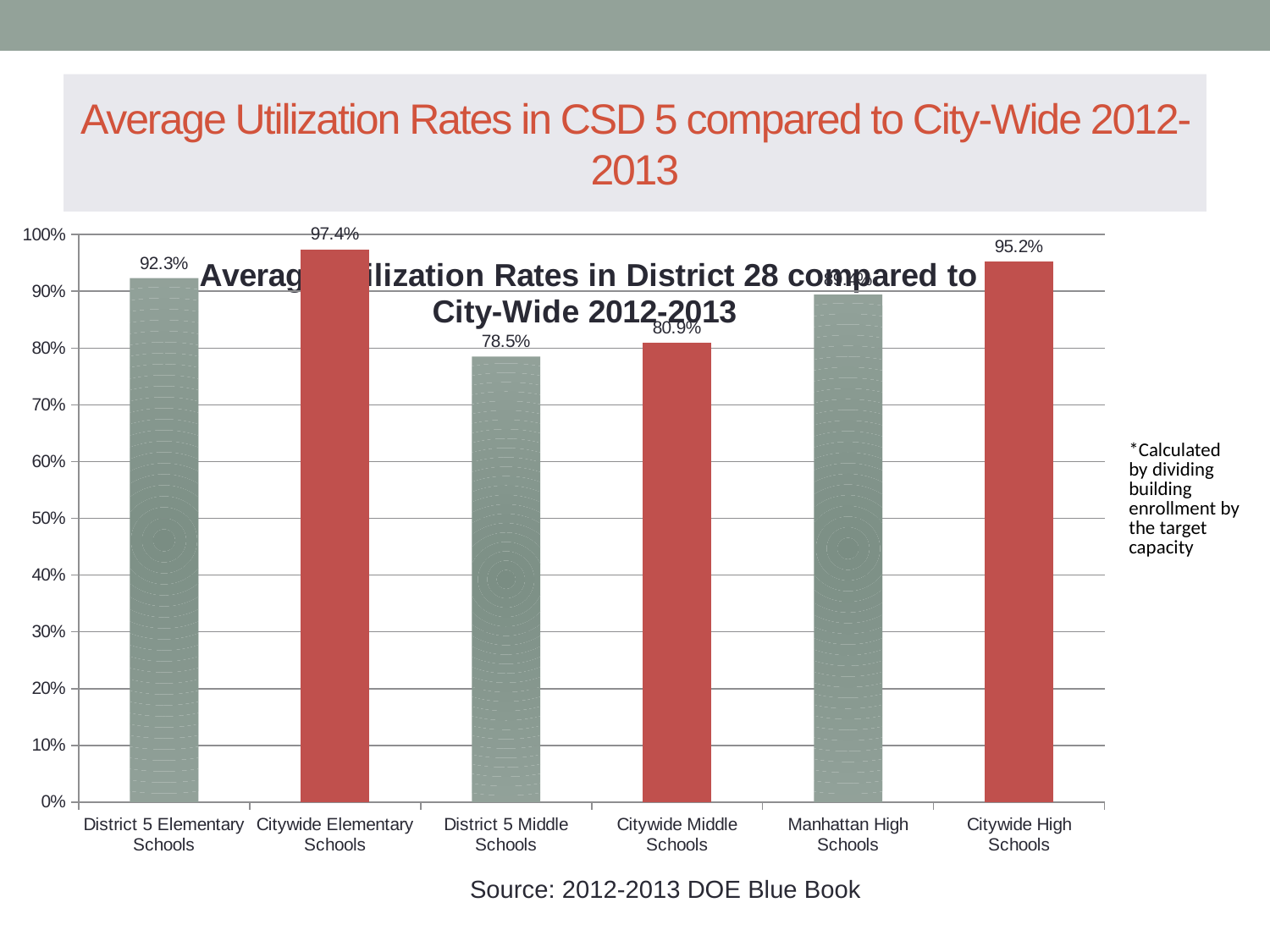
What is the average utilization rate for Citywide Middle Schools? 80.9% How many categories are shown on the x axis of the chart? 6 What is the average utilization rate for Citywide High Schools? 95.2% Which category has the highest utilization rate? Citywide Elementary Schools Is the value for Manhattan High Schools greater or less than 80%? greater What is the average utilization rate for District 5 Middle Schools? 78.5% What is the average utilization rate for District 5 Elementary Schools? 92.3% What kind of chart is shown on the slide? bar chart What is the average utilization rate for Citywide Elementary Schools? 97.4% Which has a higher utilization rate, District 5 Middle Schools or Citywide Middle Schools? Citywide Middle Schools Which category has the lowest utilization rate? District 5 Middle Schools How much higher is the utilization rate for Citywide Elementary Schools than for District 5 Elementary Schools? 5.1 percentage points